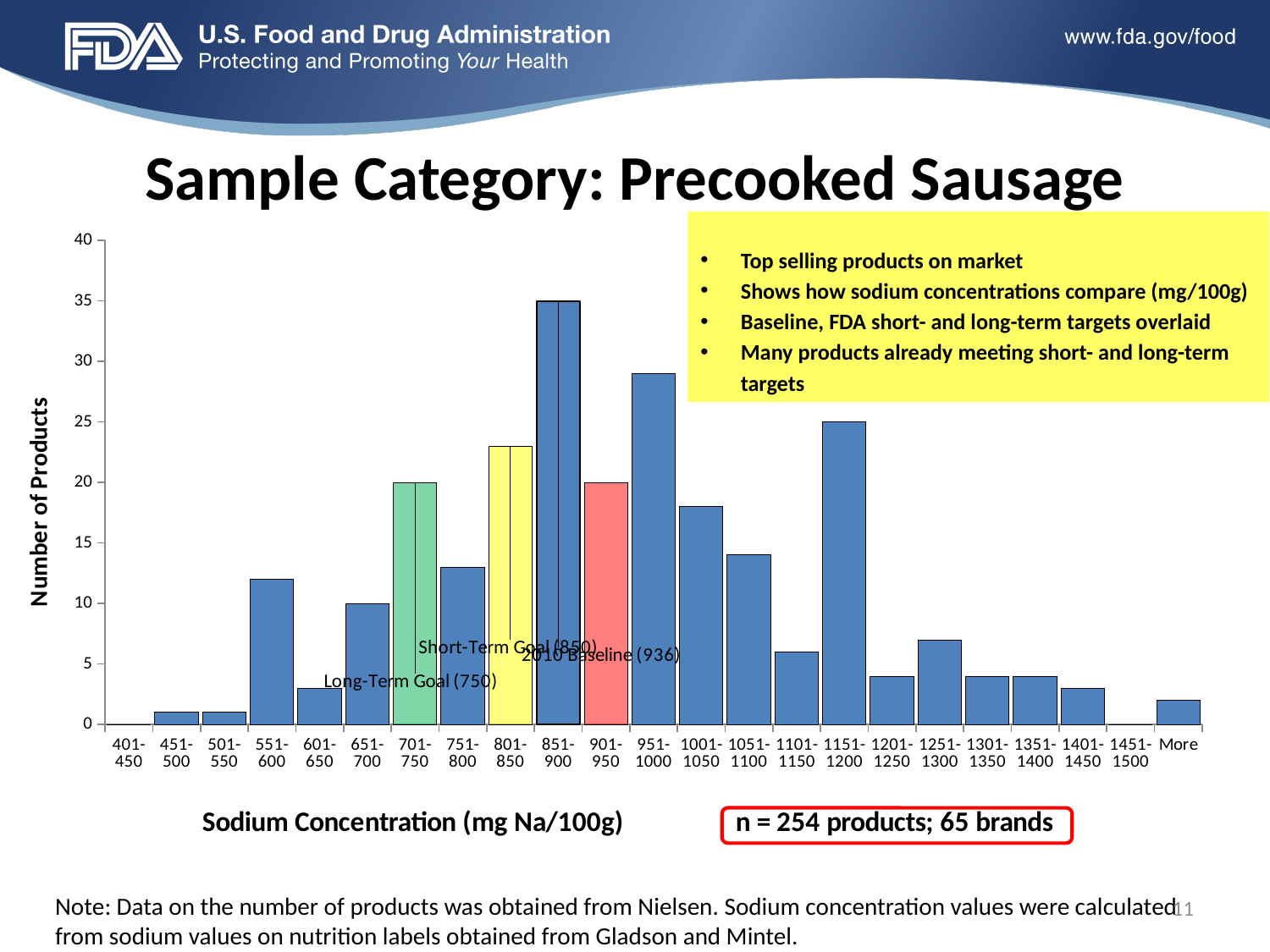
Is the number of products in the 951-1000 range greater or less than 25? greater How many products are in the 1151-1200 mg Na/100g range? 25 Which sodium concentration range has the highest number of products? 851-900 Which range has more products, 951-1000 or 1151-1200? 951-1000 How many sodium concentration ranges (including "More") are shown on the x axis? 23 How many products are in the 851-900 mg Na/100g range? 35 What is the difference in number of products between the 851-900 range and the 701-750 range? 15 How many products are in the 701-750 mg Na/100g range? 20 What is the label of the x axis? Sodium Concentration (mg Na/100g) How many products are in the 651-700 mg Na/100g range? 10 Is the number of products in the 1001-1050 range greater or less than 20? less What kind of chart is shown on the slide? bar chart